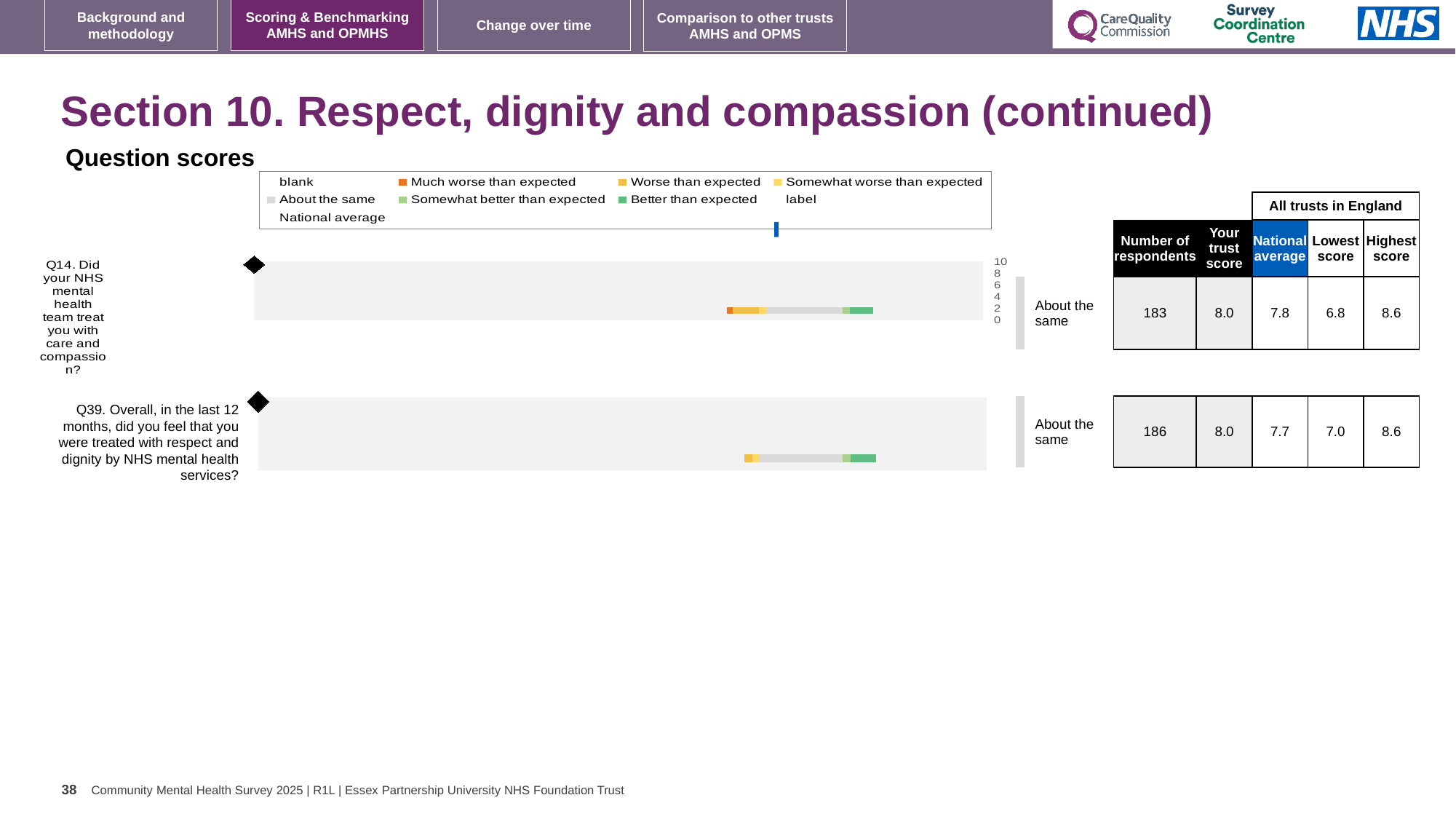
What is the highest score among all trusts in England for Q39? 8.6 What benchmarking category is shown for Q14 in the question scores chart? About the same What is the trust score for Q14 (Did your NHS mental health team treat you with care and compassion?)? 8.0 Which question has the higher lowest score across all trusts in England, Q14 or Q39? Q39 How many respondents answered Q39? 186 What is the lowest score among all trusts in England for Q14? 6.8 What is the difference between the highest and lowest trust scores for Q14? 1.8 How many questions are plotted in the question scores chart? 2 What is the national average score for Q39 (treated with respect and dignity by NHS mental health services)? 7.7 What kind of chart is used to show the question scores on this slide? Bar chart By how much does the trust score for Q39 exceed the national average for Q39? 0.3 Which question has the higher national average score, Q14 or Q39? Q14